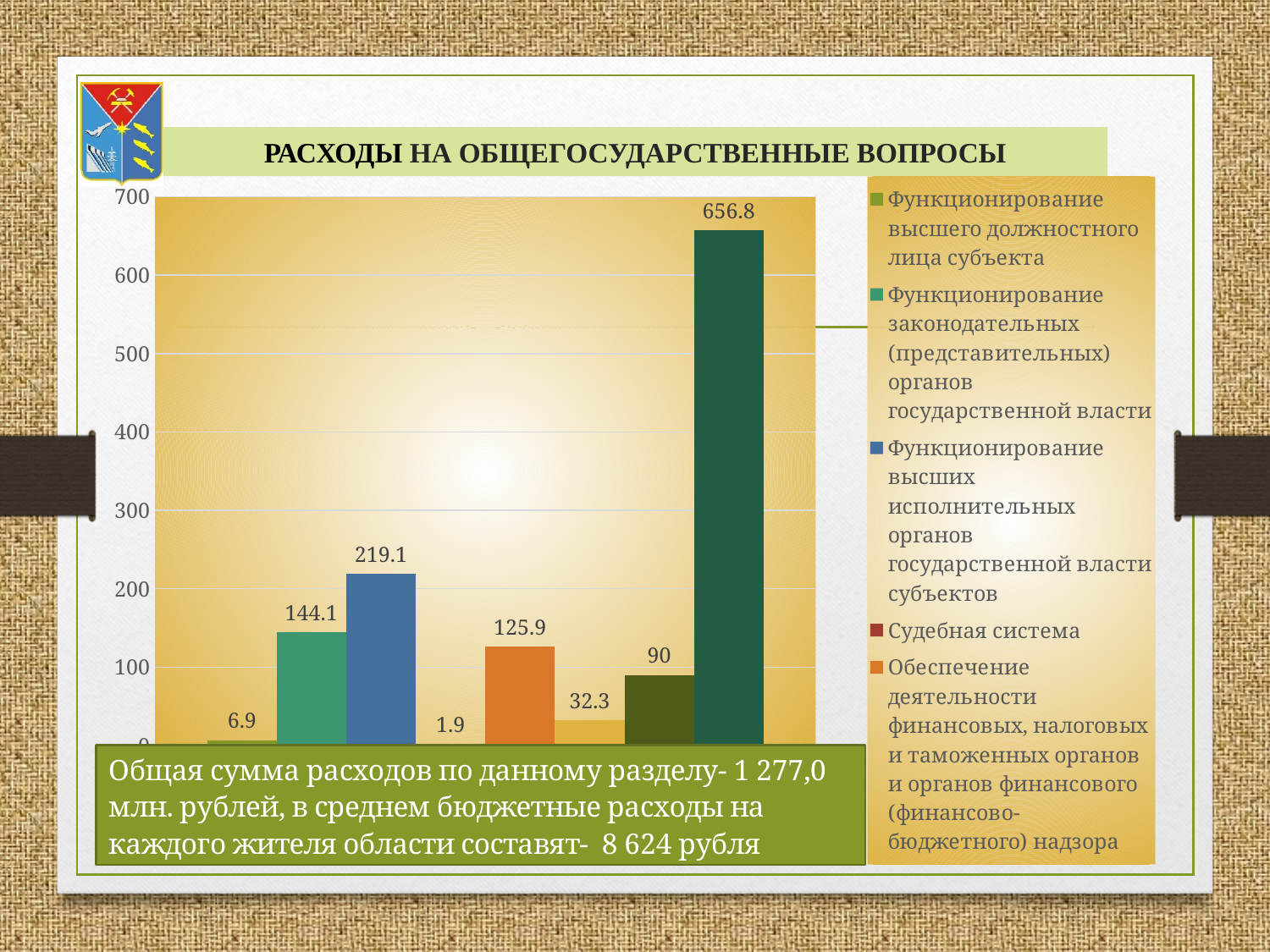
What is the value for Функционирование законодательных (представительных) органов государственной власти? 144.1 What is the highest value shown on the chart? 656.8 What is the title of the slide's chart? РАСХОДЫ НА ОБЩЕГОСУДАРСТВЕННЫЕ ВОПРОСЫ What is the value for Судебная система? 1.9 What is the difference between the value for Функционирование высших исполнительных органов государственной власти субъектов and the value for Функционирование законодательных (представительных) органов государственной власти? 75 What is the value for Функционирование высших исполнительных органов государственной власти субъектов? 219.1 What kind of chart is shown on the slide? Bar chart How many bars are plotted on the chart? 8 Which is larger: the value for Функционирование законодательных (представительных) органов государственной власти or the value for Обеспечение деятельности финансовых, налоговых и таможенных органов? Функционирование законодательных (представительных) органов государственной власти What is the value for Обеспечение деятельности финансовых, налоговых и таможенных органов и органов финансового (финансово-бюджетного) надзора? 125.9 What is the lowest value shown on the chart? 1.9 What is the value for Функционирование высшего должностного лица субъекта? 6.9